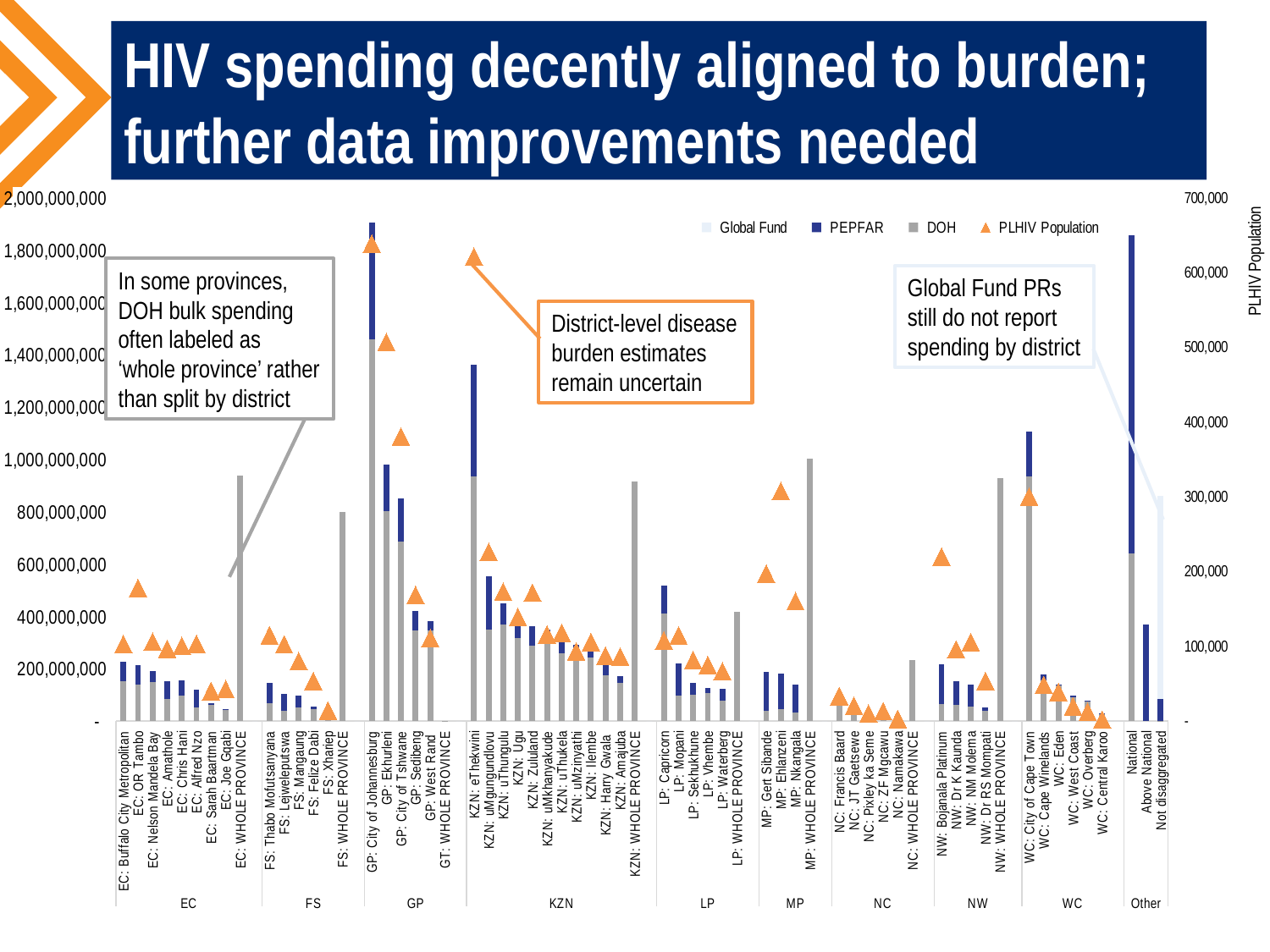
Which series in the legend is shown with orange triangle markers? PLHIV Population What is the label of the secondary (right-hand) vertical axis? PLHIV Population Which has the taller bar, KZN: eThekwini or WC: City of Cape Town? KZN: eThekwini Which category in the GP group has the tallest bar? GP: City of Johannesburg Is the total bar for NC: WHOLE PROVINCE greater or less than 400,000,000? less How many province groups are shown along the x axis (including 'Other')? 10 How many categories are shown in the GP group? 6 Which has the taller bar, EC: WHOLE PROVINCE or FS: WHOLE PROVINCE? EC: WHOLE PROVINCE How many series does the chart legend list? 4 Is the total bar for KZN: eThekwini greater or less than 1,200,000,000? greater What kind of chart is shown on the slide? bar chart Is the total bar for GP: City of Johannesburg greater or less than 1,800,000,000? greater